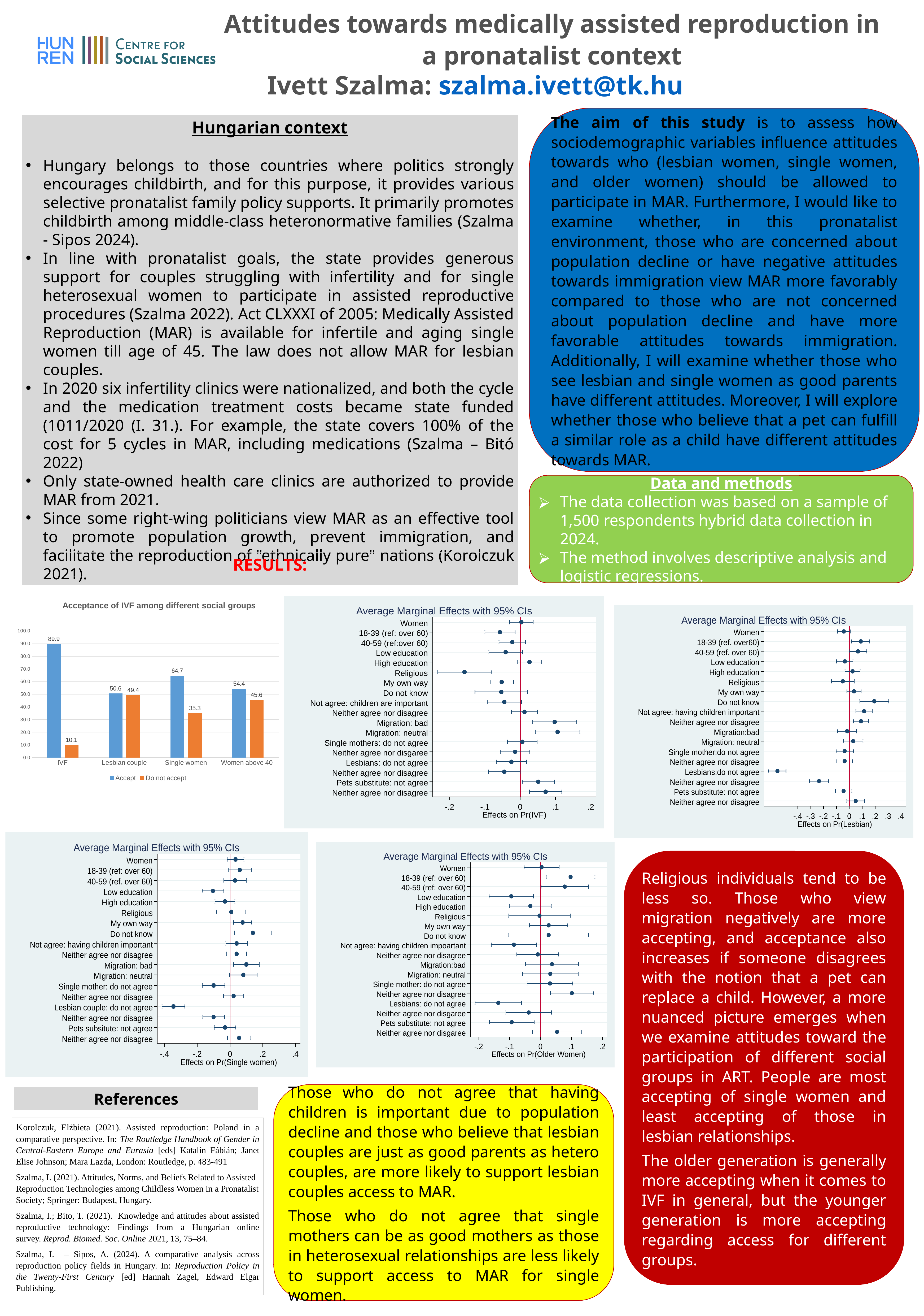
In the chart 'Acceptance of IVF among different social groups', is the Accept value for Women above 40 larger or smaller than the Accept value for Lesbian couple? larger In the chart 'Acceptance of IVF among different social groups', which colour represents the Do not accept series? orange What kind of chart is 'Acceptance of IVF among different social groups'? bar chart In the chart 'Acceptance of IVF among different social groups', what is the Do not accept value for Single women? 35.3 In the chart 'Acceptance of IVF among different social groups', which category has the lowest Accept value? Lesbian couple In the chart 'Acceptance of IVF among different social groups', what is the Accept value for IVF? 89.9 In the chart 'Acceptance of IVF among different social groups', what is the difference between the Accept values for Single women and Women above 40? 10.3 How many series does the legend of the chart 'Acceptance of IVF among different social groups' list? 2 In the 'Average Marginal Effects with 95% CIs' chart with x axis 'Effects on Pr(Lesbian)', is the point estimate for 'Lesbians:do not agree' greater or less than -.2? less In the 'Average Marginal Effects with 95% CIs' chart with x axis 'Effects on Pr(IVF)', is the point estimate for Religious greater or less than 0? less In the chart 'Acceptance of IVF among different social groups', which category has the highest Do not accept value? Lesbian couple How many categories are shown on the x axis of the chart 'Acceptance of IVF among different social groups'? 4